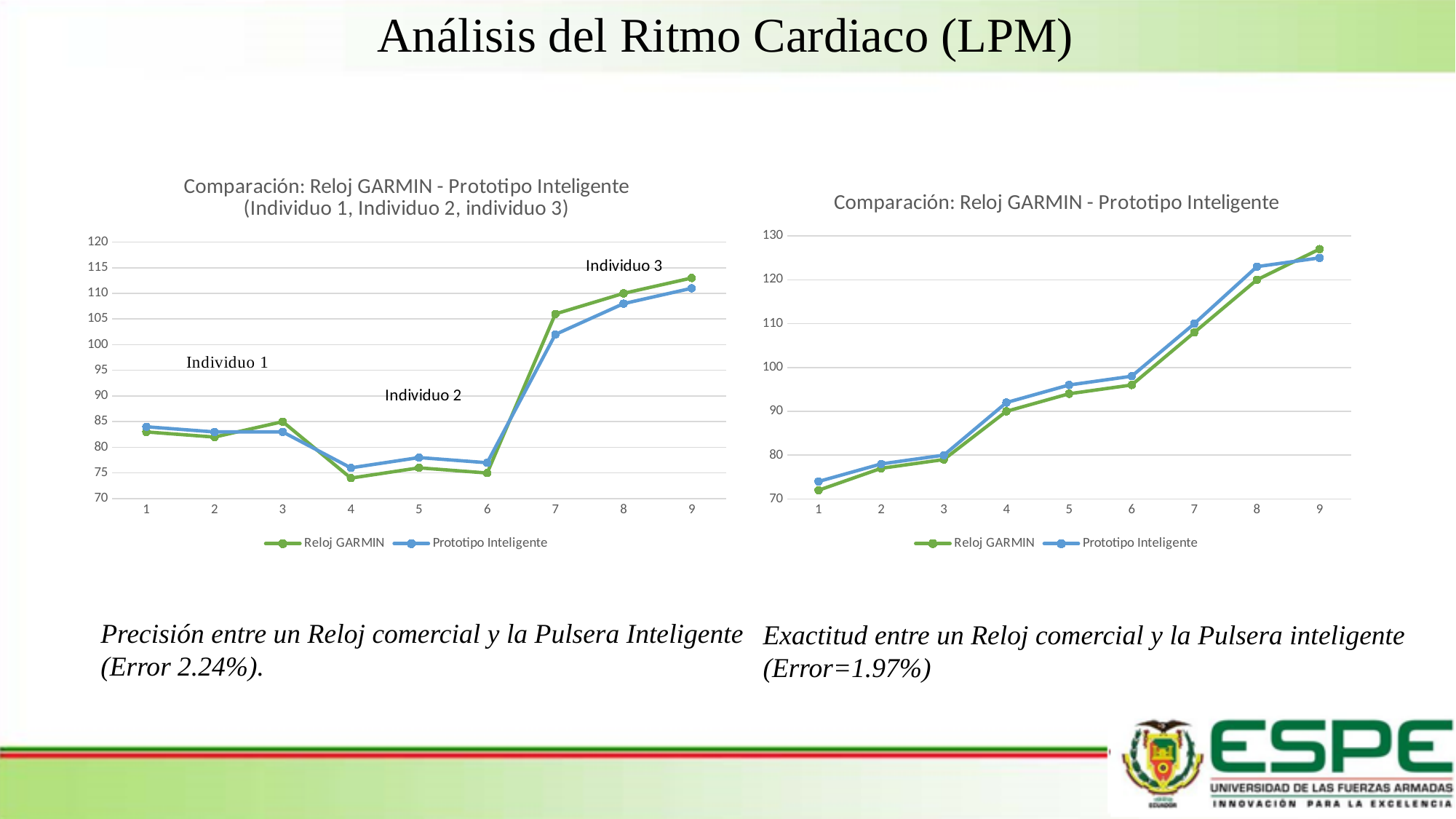
What kind of chart is the left chart on the slide? line chart In the right chart, is the Reloj GARMIN value at point 1 greater or less than 80? less In the left chart, at which x-axis point does the Reloj GARMIN series reach its lowest value? 4 In the left chart, is the Prototipo Inteligente value at point 4 greater or less than 80? less In the left chart, is the Reloj GARMIN value at point 7 greater or less than 100? greater In the right chart, do the values generally rise or fall from point 1 to point 9? rise How many points along the x axis does the left chart have? 9 In the left chart, at which x-axis point does the Reloj GARMIN series reach its highest value? 9 What are the two series named in the legend of the left chart? Reloj GARMIN and Prototipo Inteligente In the right chart, which series has the larger value at point 4, Reloj GARMIN or Prototipo Inteligente? Prototipo Inteligente How many series does the legend of the right chart list? 2